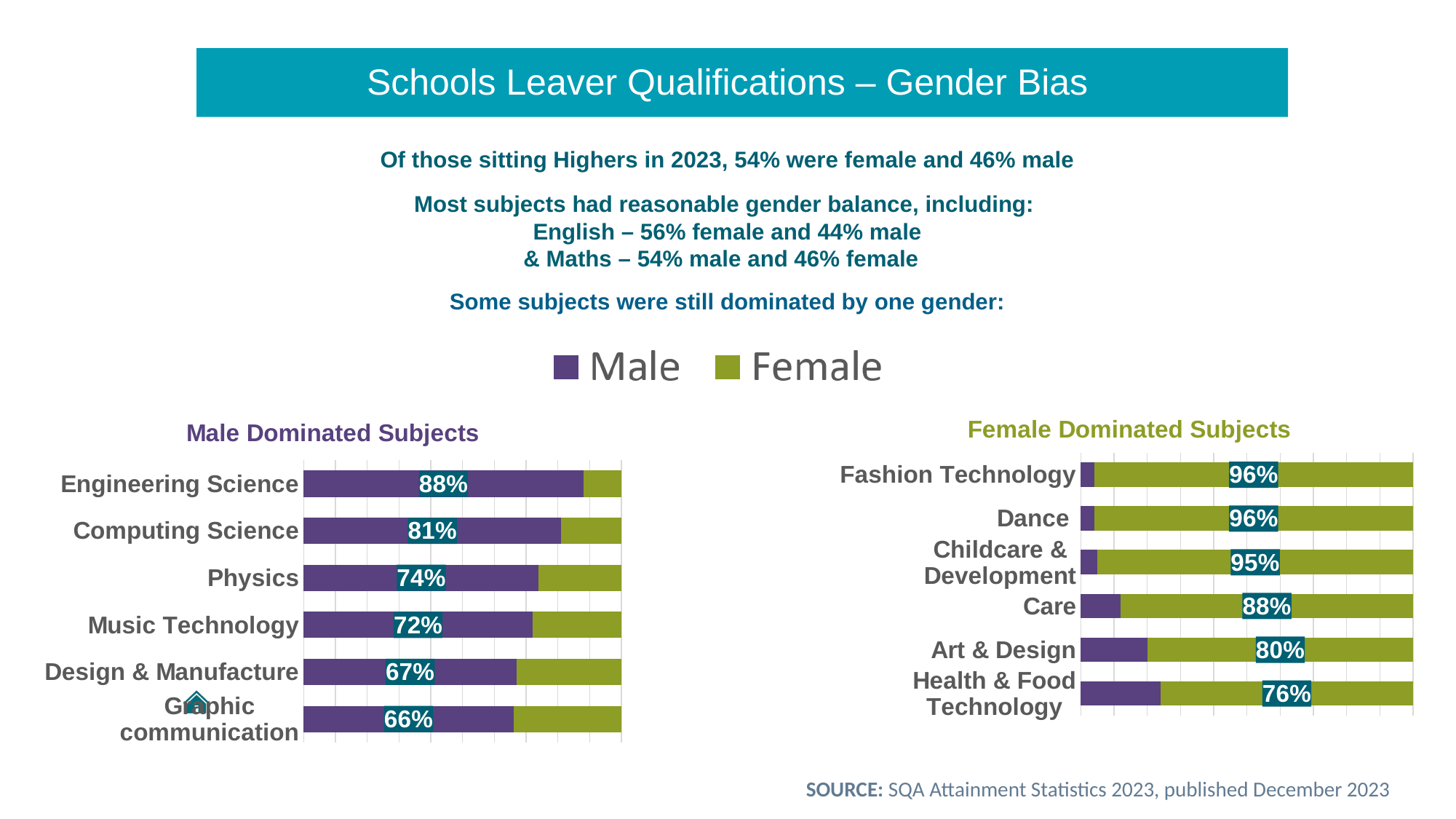
In the Male Dominated Subjects chart, what is the difference between the male percentages for Computing Science and Music Technology? 9% In the Female Dominated Subjects chart, what is the female percentage for Care? 88% How many subjects are shown in the Female Dominated Subjects chart? 6 In the Male Dominated Subjects chart, what is the male percentage for Physics? 74% In the Male Dominated Subjects chart, which has the larger male percentage, Physics or Design & Manufacture? Physics In the Female Dominated Subjects chart, which subject has the lowest female percentage? Health & Food Technology In the Male Dominated Subjects chart, which subject has the lowest male percentage? Graphic communication In the Female Dominated Subjects chart, what is the difference between the female percentages for Childcare & Development and Art & Design? 15% In the Female Dominated Subjects chart, what is the female percentage for Health & Food Technology? 76% How many series does the shared legend list for the two charts? 2 In the Male Dominated Subjects chart, what is the male percentage for Engineering Science? 88% In the Male Dominated Subjects chart, which subject has the highest male percentage? Engineering Science